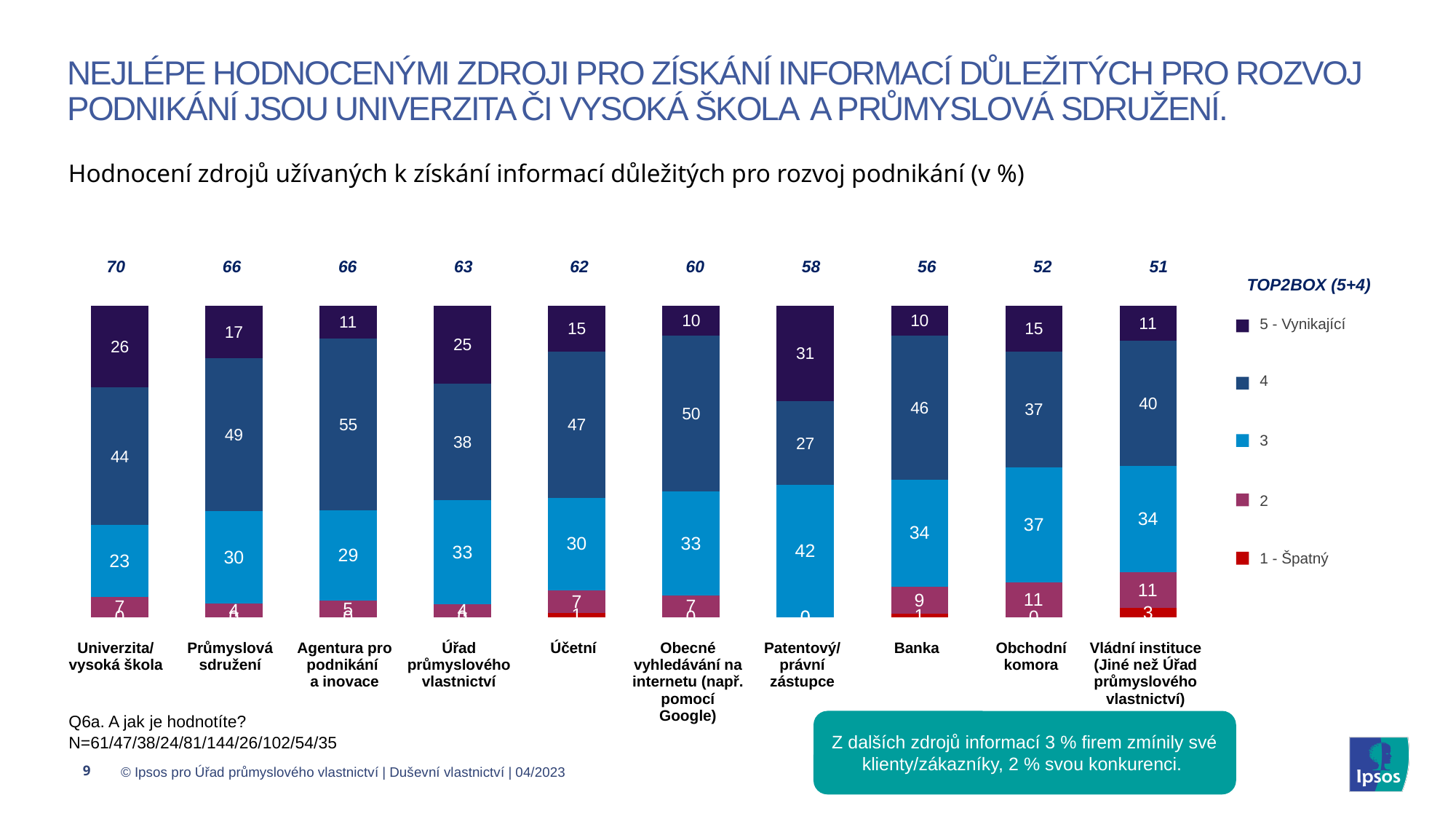
How many series does the chart legend list? 5 Which category has the highest '5 - Vynikající' value? Patentový/právní zástupce What is the difference between the TOP2BOX values for Univerzita/vysoká škola and Vládní instituce? 19 What is the value of the '1 - Špatný' segment for Vládní instituce? 3 What is the label of the first (top) entry in the chart legend? 5 - Vynikající What is the value of the '4' segment for Agentura pro podnikání a inovace? 55 How many information sources (categories) are shown on the x axis of the chart? 10 Which has a larger '3' segment value: Patentový/právní zástupce or Banka? Patentový/právní zástupce What is the value of the '5 - Vynikající' segment for Patentový/právní zástupce? 31 What is the TOP2BOX (5+4) value shown above the bar for Univerzita/vysoká škola? 70 What kind of chart is shown on the slide? Stacked bar chart Which category has the lowest TOP2BOX (5+4) value? Vládní instituce (Jiné než Úřad průmyslového vlastnictví)